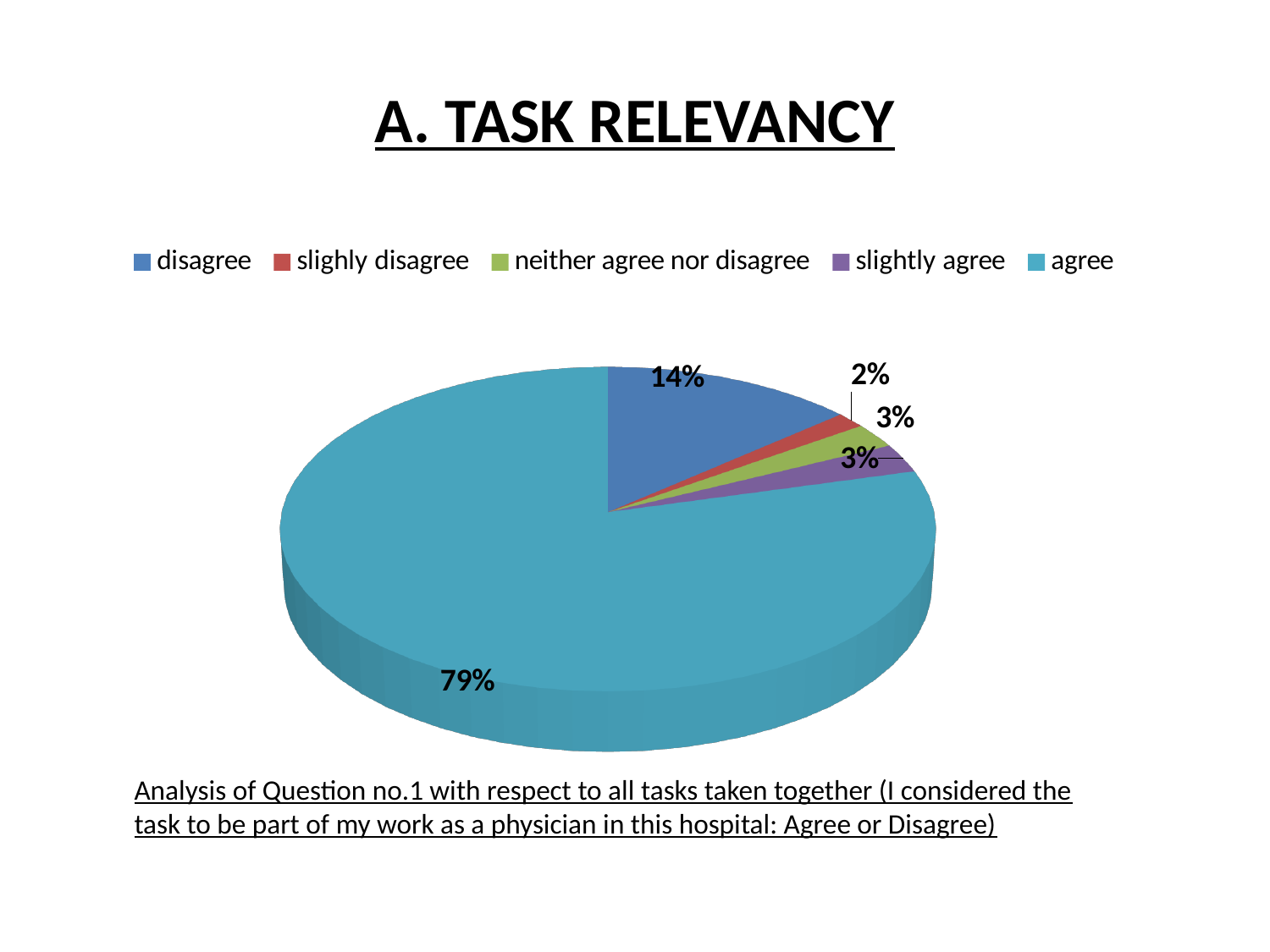
How many categories does the legend list? 5 What is the difference in percentage points between 'agree' and 'disagree'? 65 What percentage of responses are 'slightly agree'? 3% What percentage of responses are 'agree'? 79% Which response category has the largest share of the pie? agree What percentage of responses are 'slighly disagree'? 2% Which response category has the smallest share of the pie? slighly disagree Which is larger, the share for 'disagree' or the share for 'slightly agree'? disagree What percentage of responses are 'disagree'? 14% What colour is the 'agree' slice of the pie? teal What percentage of responses are 'neither agree nor disagree'? 3% What kind of chart is shown on the slide? pie chart